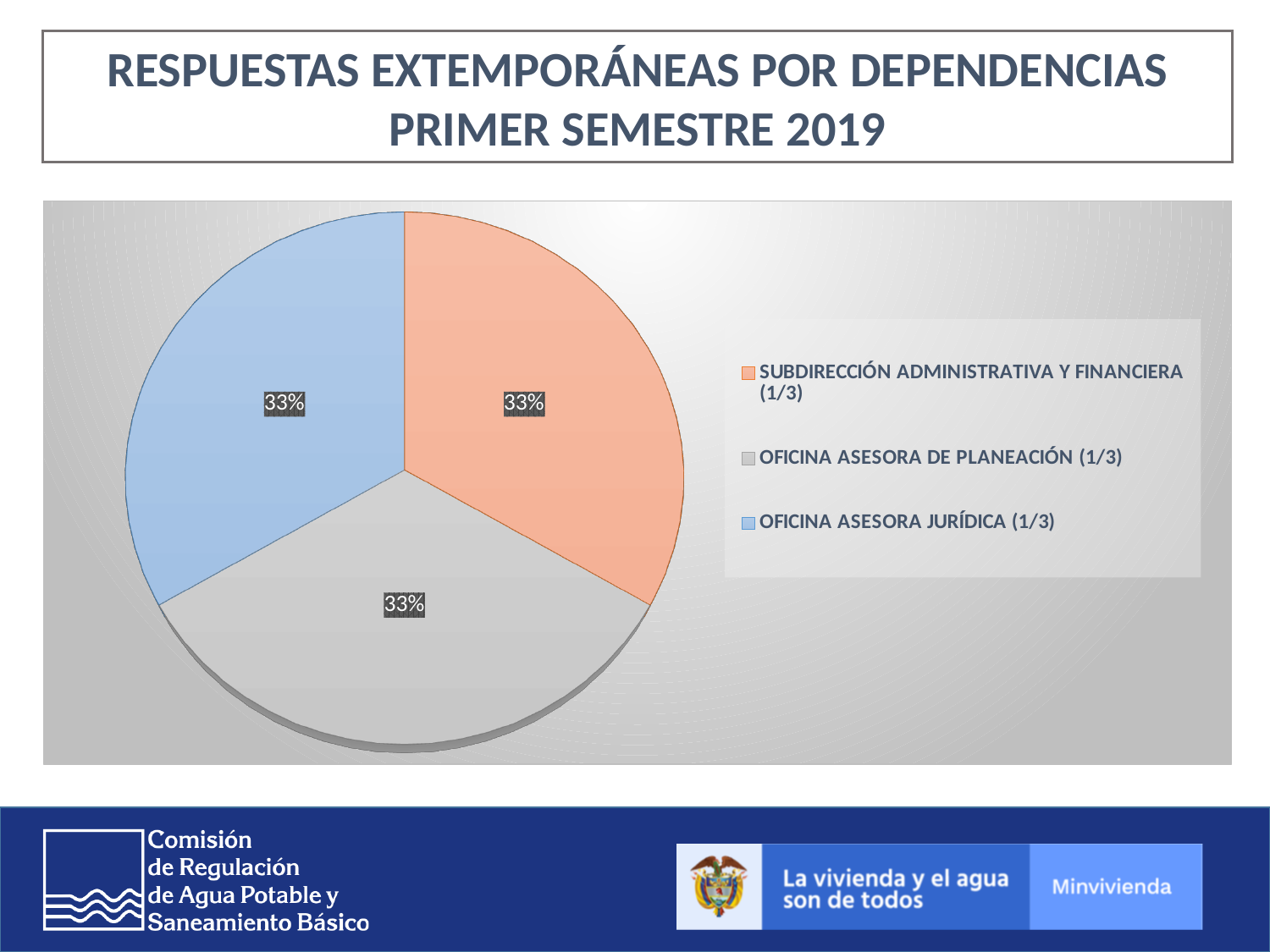
How many entries does the legend list? 3 Which legend entry is shown in orange? SUBDIRECCIÓN ADMINISTRATIVA Y FINANCIERA (1/3) What is the difference between the share for OFICINA ASESORA JURÍDICA (1/3) and the share for OFICINA ASESORA DE PLANEACIÓN (1/3)? 0% Which legend entry is shown in blue? OFICINA ASESORA JURÍDICA (1/3) What percentage share does the slice for OFICINA ASESORA DE PLANEACIÓN (1/3) show? 33% What percentage share does the slice for OFICINA ASESORA JURÍDICA (1/3) show? 33% What fraction is shown in parentheses after each dependency name in the legend? 1/3 What percentage share does the slice for SUBDIRECCIÓN ADMINISTRATIVA Y FINANCIERA (1/3) show? 33% What kind of chart is shown on the slide? pie chart How many slices does the pie chart have? 3